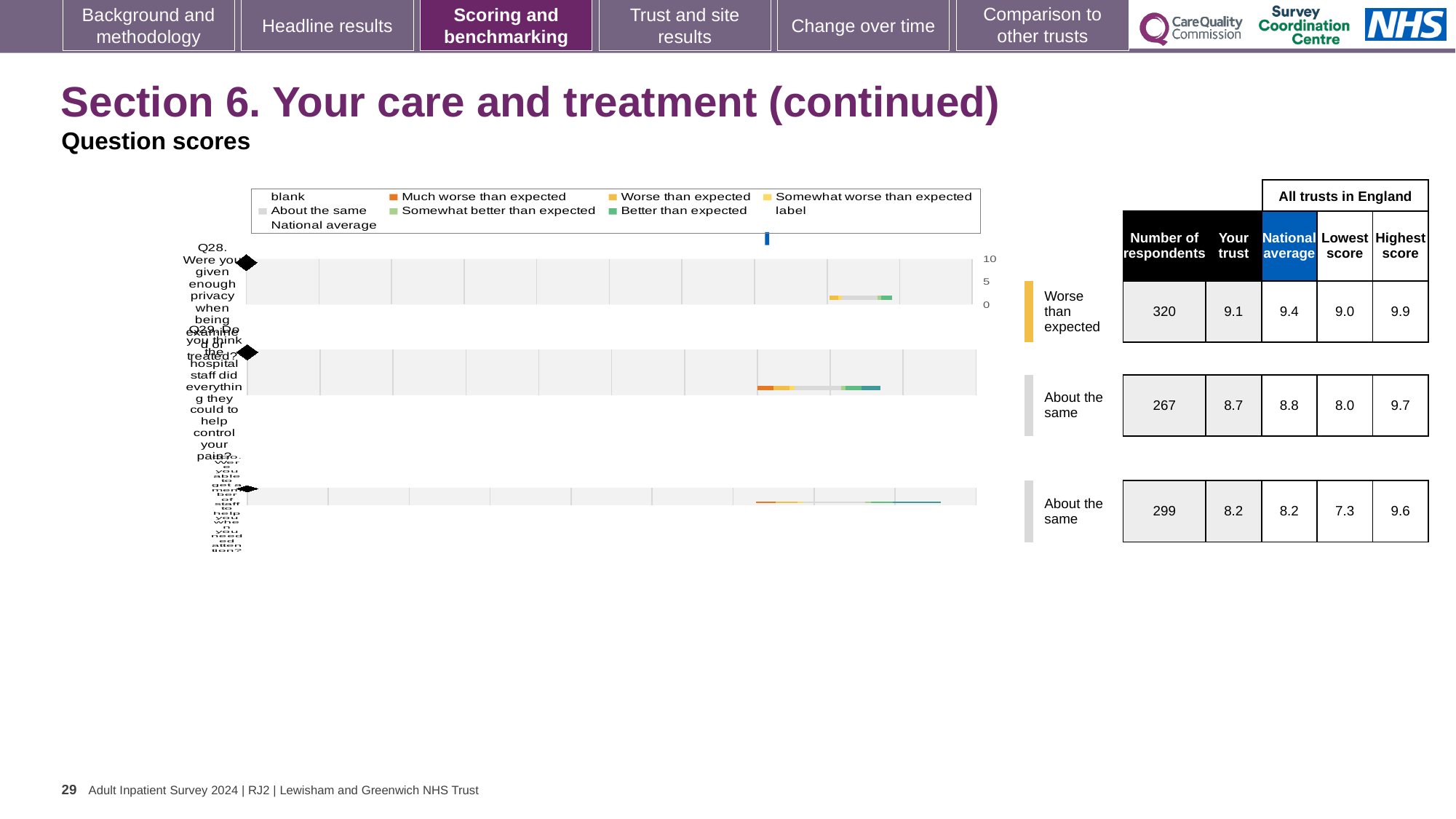
How many questions (categories) are plotted in the chart? 3 What is the lowest score among all trusts in England for Q29? 8.0 Which question has the lowest 'Your trust' score? Q30 What is the highest score among all trusts in England for Q30? 9.6 What is the difference between the highest and lowest scores for Q28? 0.9 What kind of chart is shown on the slide? bar chart Which question is plotted in the top row of the chart? Q28 For Q28, which is larger: the 'Your trust' score or the national average? National average Which question has the largest number of respondents? Q28 What is the national average score for Q28? 9.4 How many respondents answered Q29 (hospital staff helping control pain)? 267 What is the 'Your trust' score for Q28 (privacy when being examined or treated)? 9.1